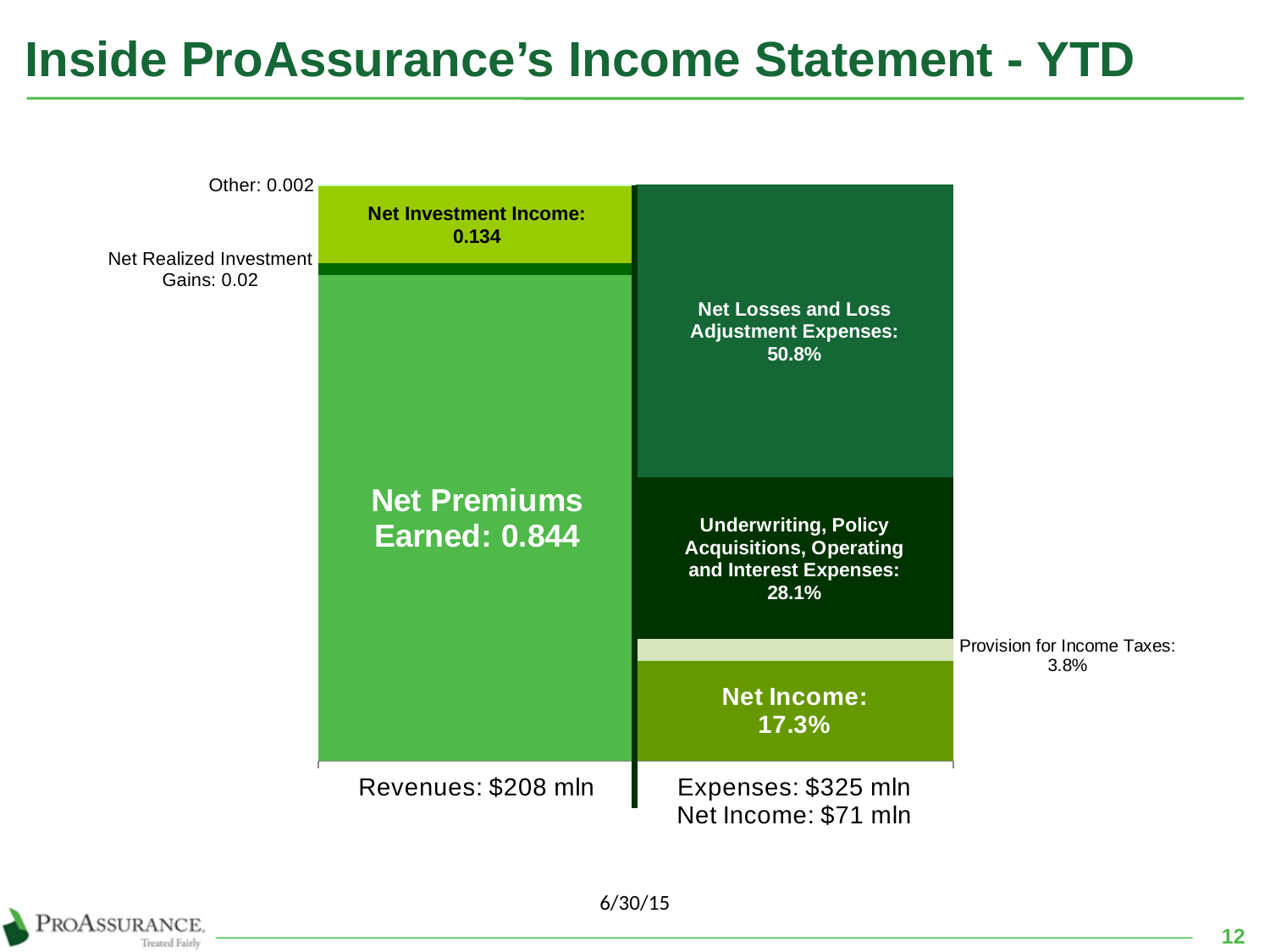
Which segment of the Revenues bar is the largest? Net Premiums Earned What kind of chart is shown on the slide? Stacked bar chart What is the difference between the Net Losses and Loss Adjustment Expenses percentage and the Underwriting, Policy Acquisitions, Operating and Interest Expenses percentage? 22.7% What is the value shown for Net Realized Investment Gains? 0.02 How many segments make up the Revenues bar? 4 What percentage is shown for Provision for Income Taxes? 3.8% What percentage is shown for Net Income in the right-hand bar? 17.3% Which is larger, Net Investment Income or Net Realized Investment Gains? Net Investment Income What percentage is shown for Net Losses and Loss Adjustment Expenses? 50.8% Which segment of the right-hand bar is the smallest? Provision for Income Taxes What is the value shown for Net Premiums Earned in the Revenues bar? 0.844 What is the value shown for Net Investment Income in the Revenues bar? 0.134